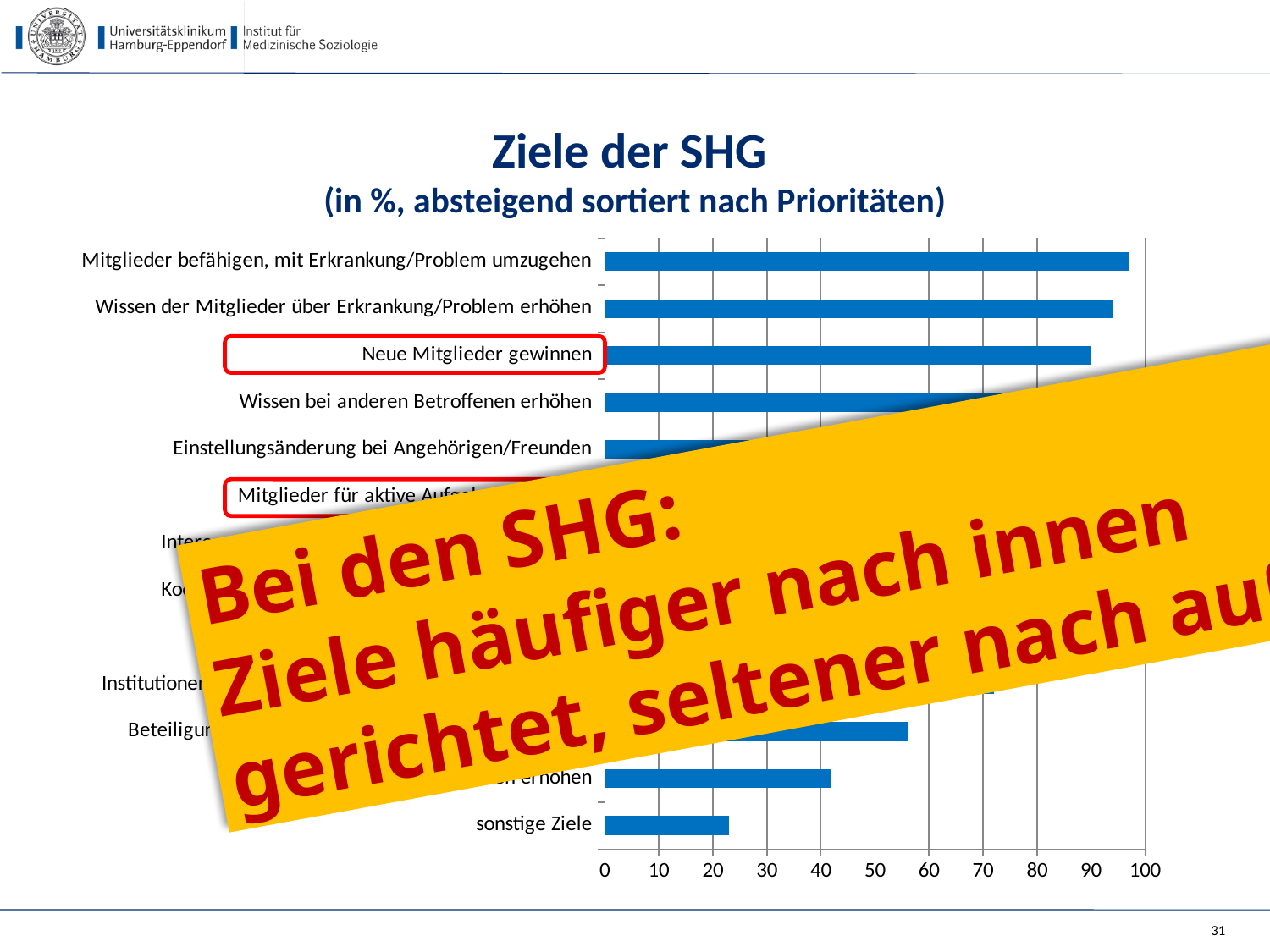
Is the value for 'sonstige Ziele' greater or less than 30? less Which has a larger value: 'Mitglieder befähigen, mit Erkrankung/Problem umzugehen' or 'sonstige Ziele'? Mitglieder befähigen, mit Erkrankung/Problem umzugehen Which category has the highest value in the chart? Mitglieder befähigen, mit Erkrankung/Problem umzugehen Is the value for 'Mitglieder befähigen, mit Erkrankung/Problem umzugehen' greater or less than 90? greater Do the bar values increase or decrease from the top of the chart to the bottom? decrease Is the value for 'Wissen der Mitglieder über Erkrankung/Problem erhöhen' greater or less than 90? greater Which has a larger value: 'Neue Mitglieder gewinnen' or 'Mitglieder befähigen, mit Erkrankung/Problem umzugehen'? Mitglieder befähigen, mit Erkrankung/Problem umzugehen What is the title of the chart? Ziele der SHG (in %, absteigend sortiert nach Prioritäten) Which category has the lowest value in the chart? sonstige Ziele What is the maximum value shown on the horizontal axis of the chart? 100 What kind of chart is shown on the slide? bar chart